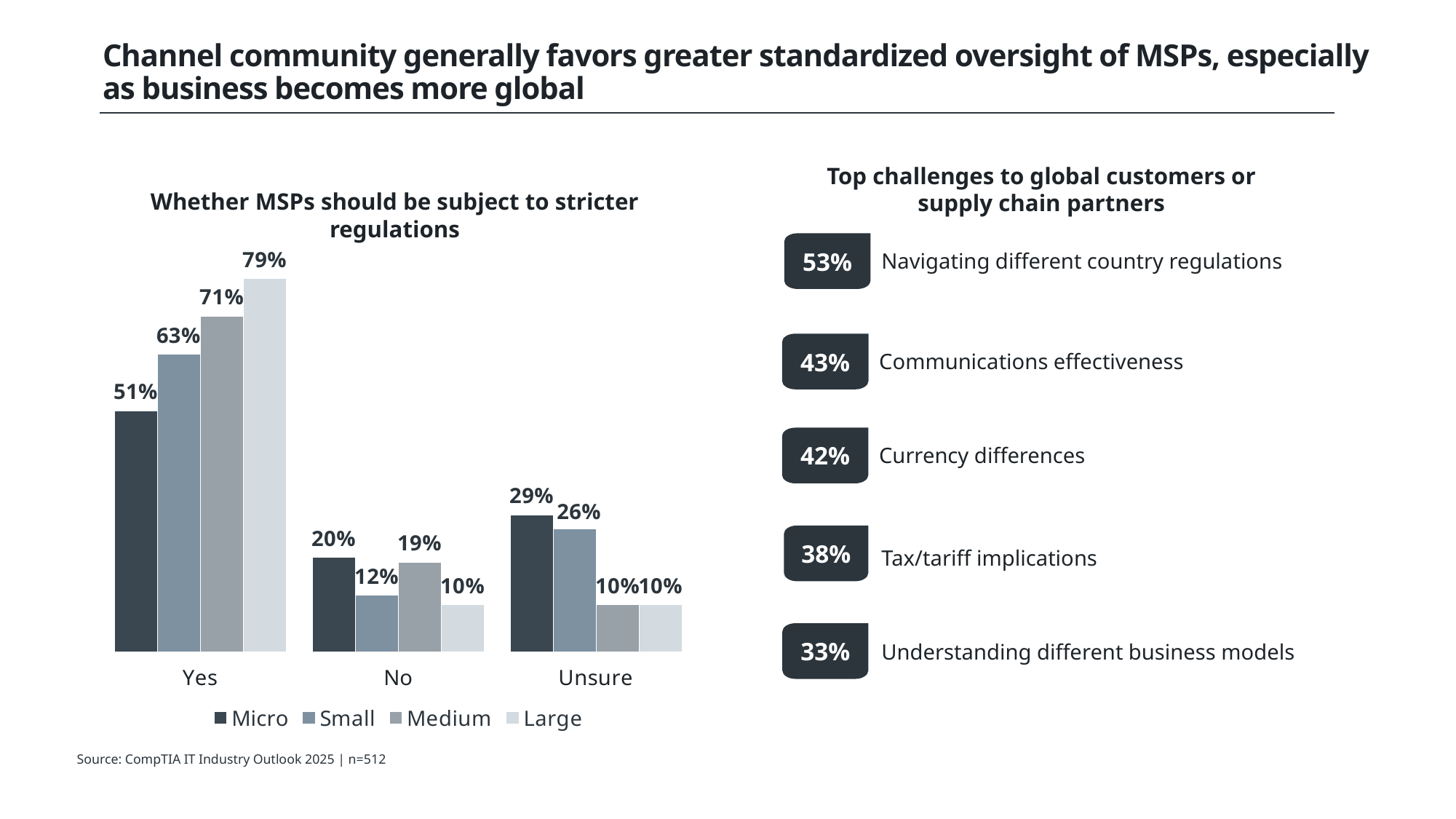
In the chart 'Whether MSPs should be subject to stricter regulations', what is the value for Micro in the Unsure category? 29% In the chart 'Whether MSPs should be subject to stricter regulations', what is the difference between the Large and Micro values in the Yes category? 28% In the chart 'Whether MSPs should be subject to stricter regulations', do the values for Large rise or fall from Yes to No to Unsure? Fall from Yes (79%) to No (10%), then stay flat at 10% for Unsure In the chart 'Whether MSPs should be subject to stricter regulations', which is larger in the No category: Micro or Medium? Micro In the chart 'Whether MSPs should be subject to stricter regulations', how many series does the legend list? 4 In the chart 'Whether MSPs should be subject to stricter regulations', what is the difference between the Micro and Small values in the Unsure category? 3% In the chart 'Whether MSPs should be subject to stricter regulations', which series has the highest value in the Yes category? Large What kind of chart is 'Whether MSPs should be subject to stricter regulations'? Bar chart In the chart 'Whether MSPs should be subject to stricter regulations', which series has the lowest value in the Yes category? Micro In the chart 'Whether MSPs should be subject to stricter regulations', what is the value for Small in the No category? 12% In the chart 'Whether MSPs should be subject to stricter regulations', what is the value for Large in the Yes category? 79% In the chart 'Whether MSPs should be subject to stricter regulations', how many categories are shown on the x axis? 3